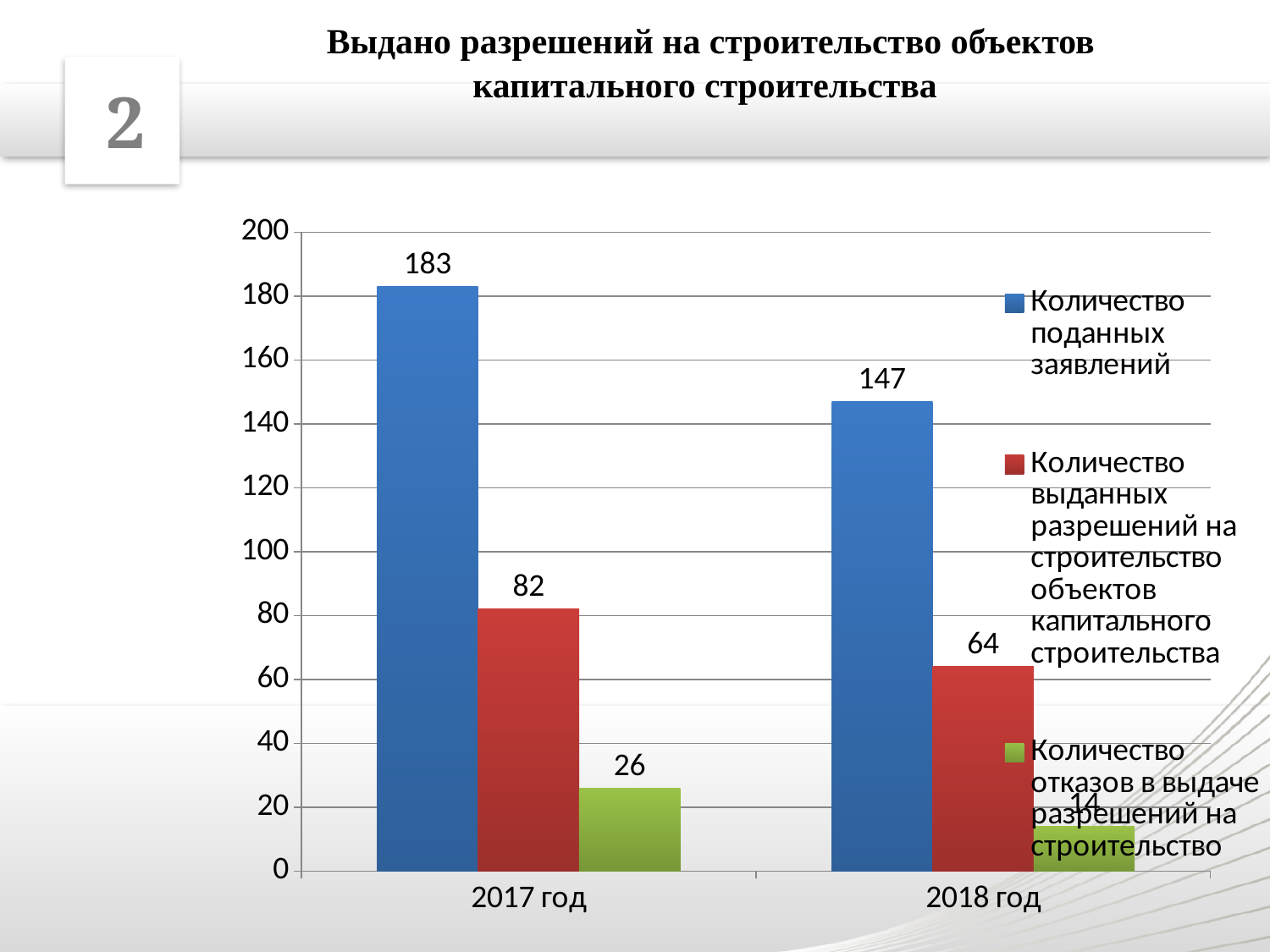
How many categories are shown on the x axis? 2 Does the value of 'Количество поданных заявлений' rise or fall from 2017 год to 2018 год? Fall What kind of chart is shown on the slide? Bar chart What is the difference between 'Количество поданных заявлений' in 2017 год and 2018 год? 36 What is the value of 'Количество выданных разрешений на строительство объектов капитального строительства' for 2017 год? 82 What is the value of 'Количество поданных заявлений' for 2018 год? 147 What is the value of 'Количество поданных заявлений' for 2017 год? 183 What is the value of 'Количество выданных разрешений на строительство объектов капитального строительства' for 2018 год? 64 What is the value of 'Количество отказов в выдаче разрешений на строительство' for 2017 год? 26 Which year has the higher value for 'Количество поданных заявлений'? 2017 год What is the difference between 'Количество выданных разрешений на строительство объектов капитального строительства' in 2017 год and 2018 год? 18 How many series does the legend list? 3